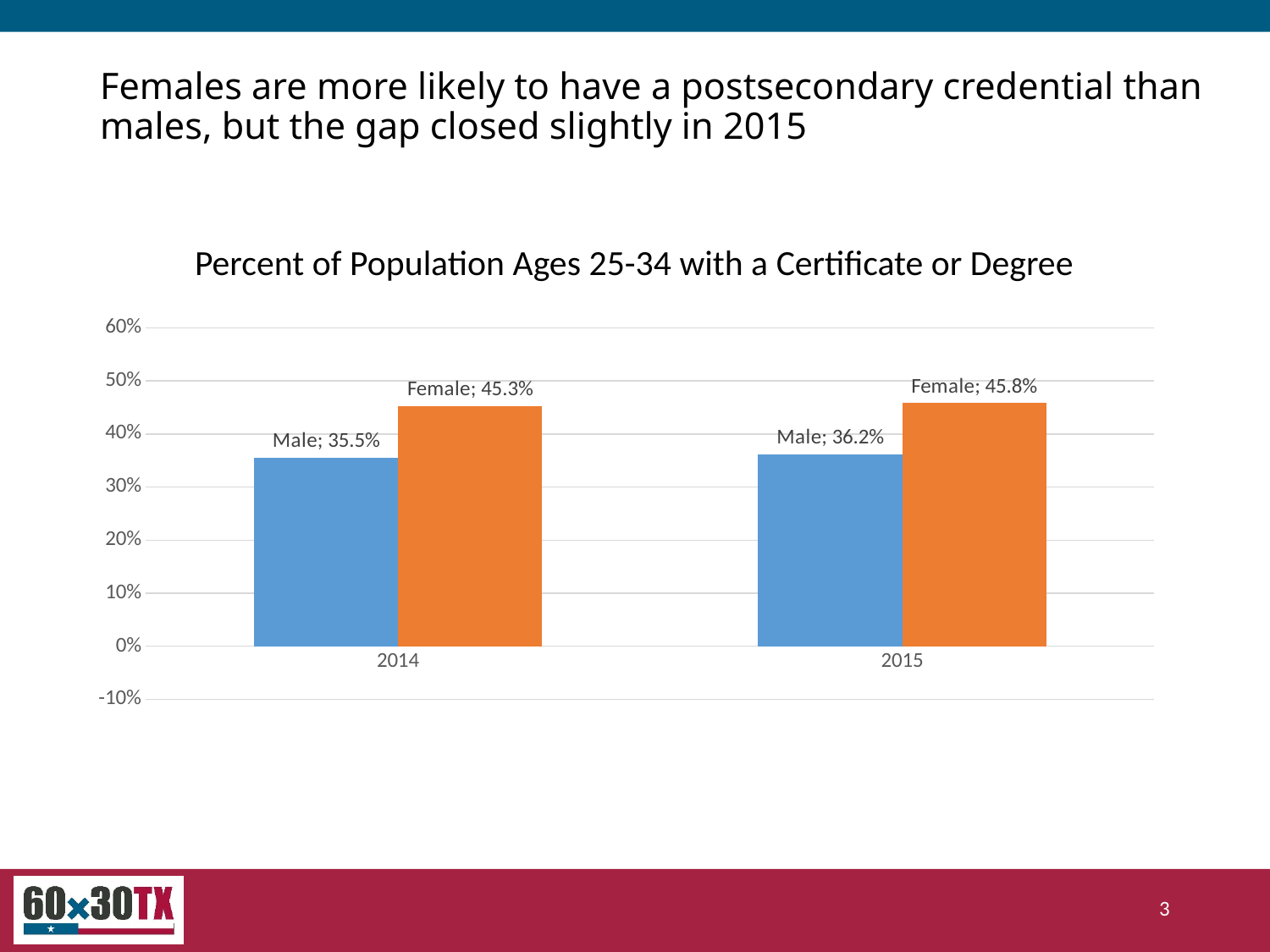
By how much did the Male value increase from 2014 to 2015? 0.7 percentage points Which bar has the highest value on the chart? Female in 2015 What is the title of the chart? Percent of Population Ages 25-34 with a Certificate or Degree What is the value for Female in 2014? 45.3% Which is larger in 2015, the Male value or the Female value? Female How many years are shown on the x axis? 2 Which bar has the lowest value on the chart? Male in 2014 What is the value for Male in 2015? 36.2% What kind of chart is shown on the slide? Bar chart What is the value for Female in 2015? 45.8% What is the value for Male in 2014? 35.5% What is the difference between the Female and Male values in 2014? 9.8 percentage points